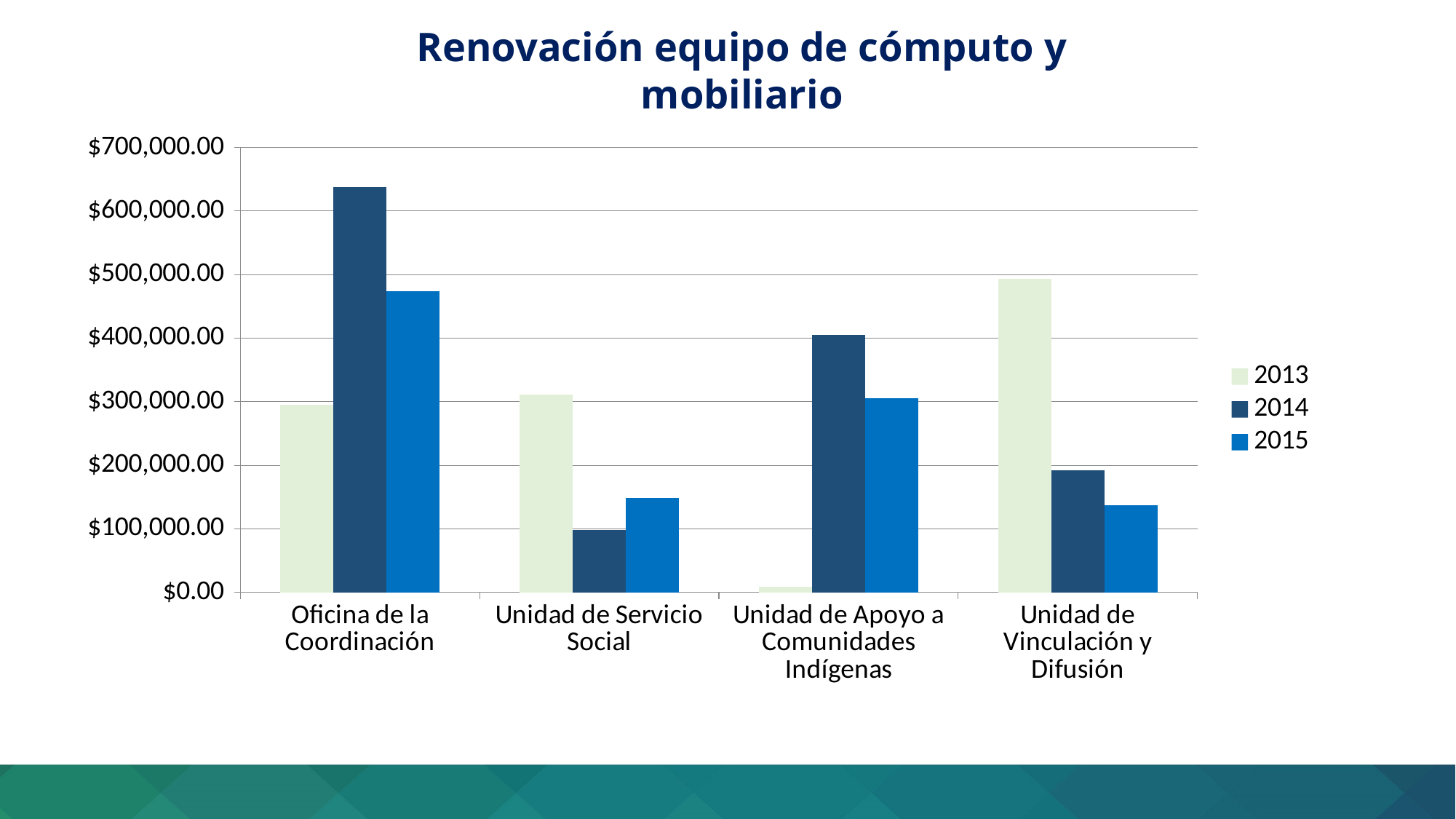
Which category has the lowest value for 2013? Unidad de Apoyo a Comunidades Indígenas Is the 2014 value for Oficina de la Coordinación greater or less than $600,000.00? greater How many series does the legend list? 3 Is the 2013 value for Unidad de Apoyo a Comunidades Indígenas greater or less than $100,000.00? less Which category has the highest value for 2013? Unidad de Vinculación y Difusión Is the 2015 value for Unidad de Vinculación y Difusión greater or less than $100,000.00? greater What kind of chart is shown on the slide? Bar chart What is the title of the chart? Renovación equipo de cómputo y mobiliario For Unidad de Servicio Social, which is larger: the 2013 value or the 2014 value? 2013 Which category has the lowest value for 2014? Unidad de Servicio Social Which category has the highest value for 2014? Oficina de la Coordinación How many categories are shown on the x axis? 4